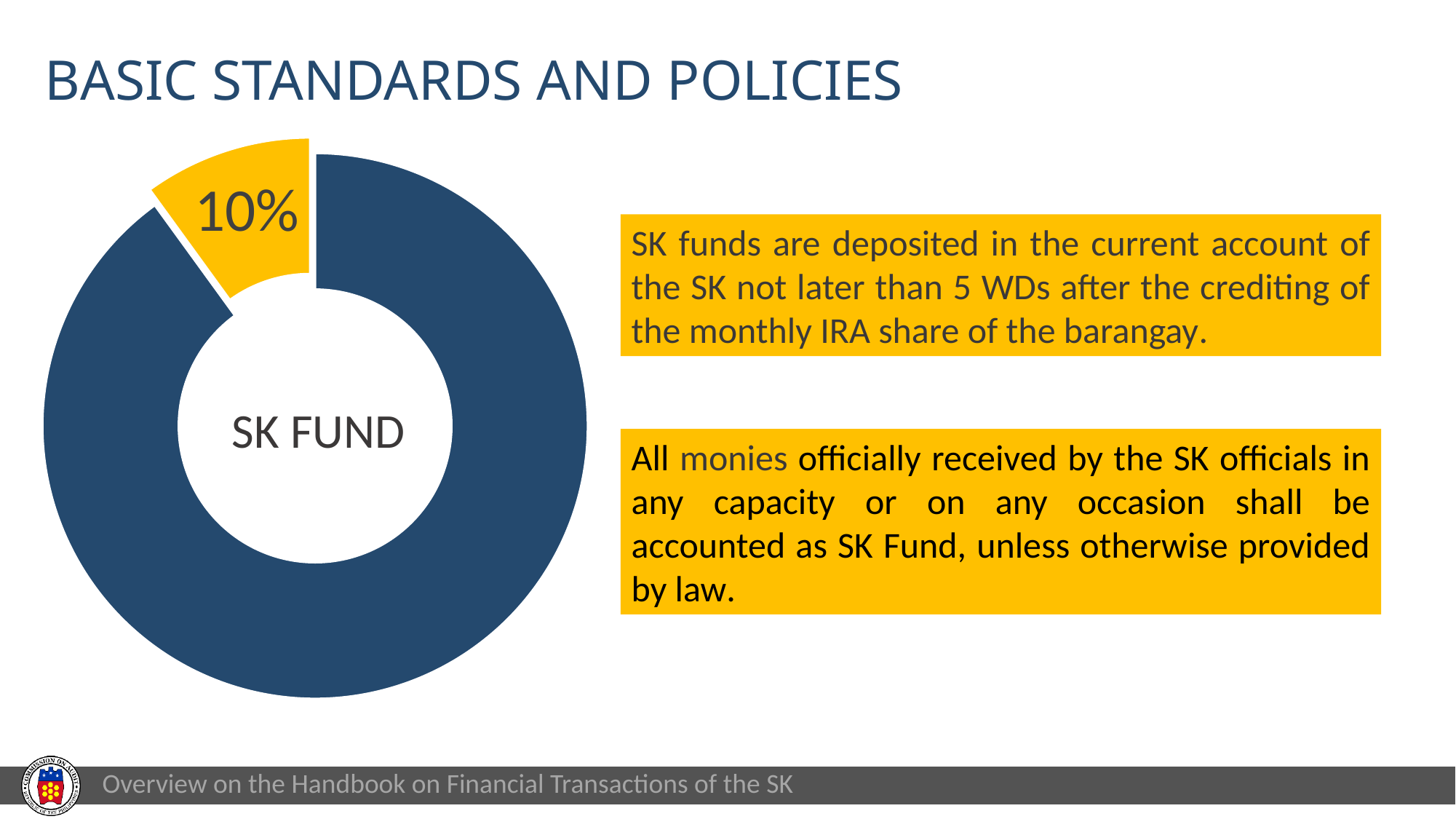
What kind of chart is shown on the slide? doughnut chart What percentage is printed on the yellow slice of the doughnut chart? 10% What colour is the slice labelled 10%? yellow How many slices does the doughnut chart have? 2 Which slice of the doughnut chart is the smallest? the yellow slice (10%) What text is written in the centre of the doughnut chart? SK FUND What share of the doughnut does the yellow slice represent? 10% Which slice of the doughnut chart is larger, the blue one or the yellow one? the blue one